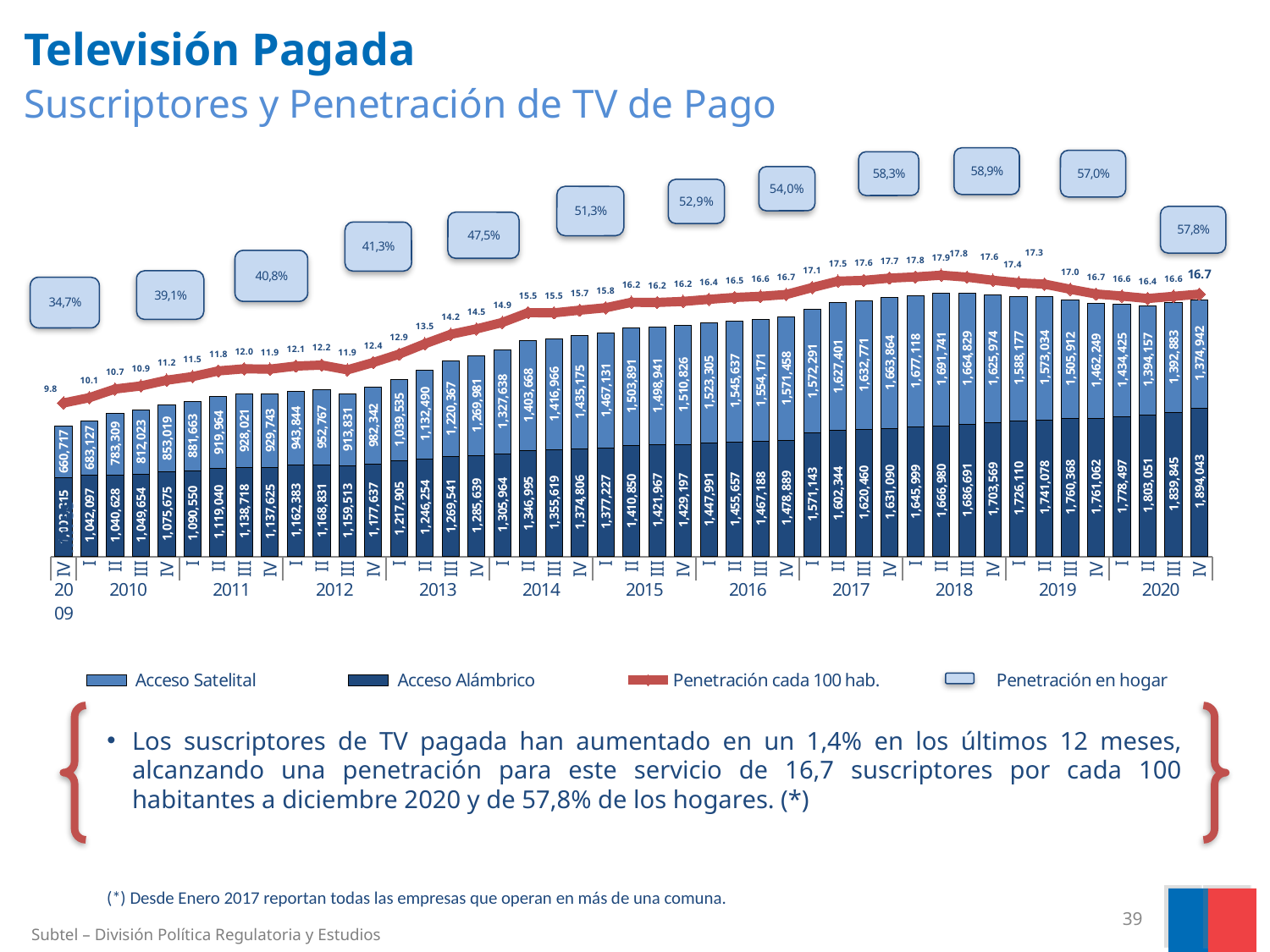
Which is larger in IV 2020, Acceso Alámbrico or Acceso Satelital? Acceso Alámbrico In which year is the Penetración en hogar value the lowest? 2009 In which year is the Penetración en hogar value the highest? 2018 What is the total of the stacked bar for IV 2020 (Acceso Alámbrico plus Acceso Satelital)? 3,268,985 What is the highest value reached by the Penetración cada 100 hab. line? 17.9 What is the Penetración cada 100 hab. value for IV 2020? 16.7 By how many percentage points does Penetración en hogar in 2020 exceed that of 2019? 0,8 What is the Penetración en hogar value shown for 2018? 58,9% What is the value of Acceso Satelital for IV 2020? 1,374,942 What is the value of Acceso Alámbrico for IV 2020? 1,894,043 How many series does the legend list? 4 Does the Acceso Satelital value rise or fall from II 2018 to IV 2020? fall